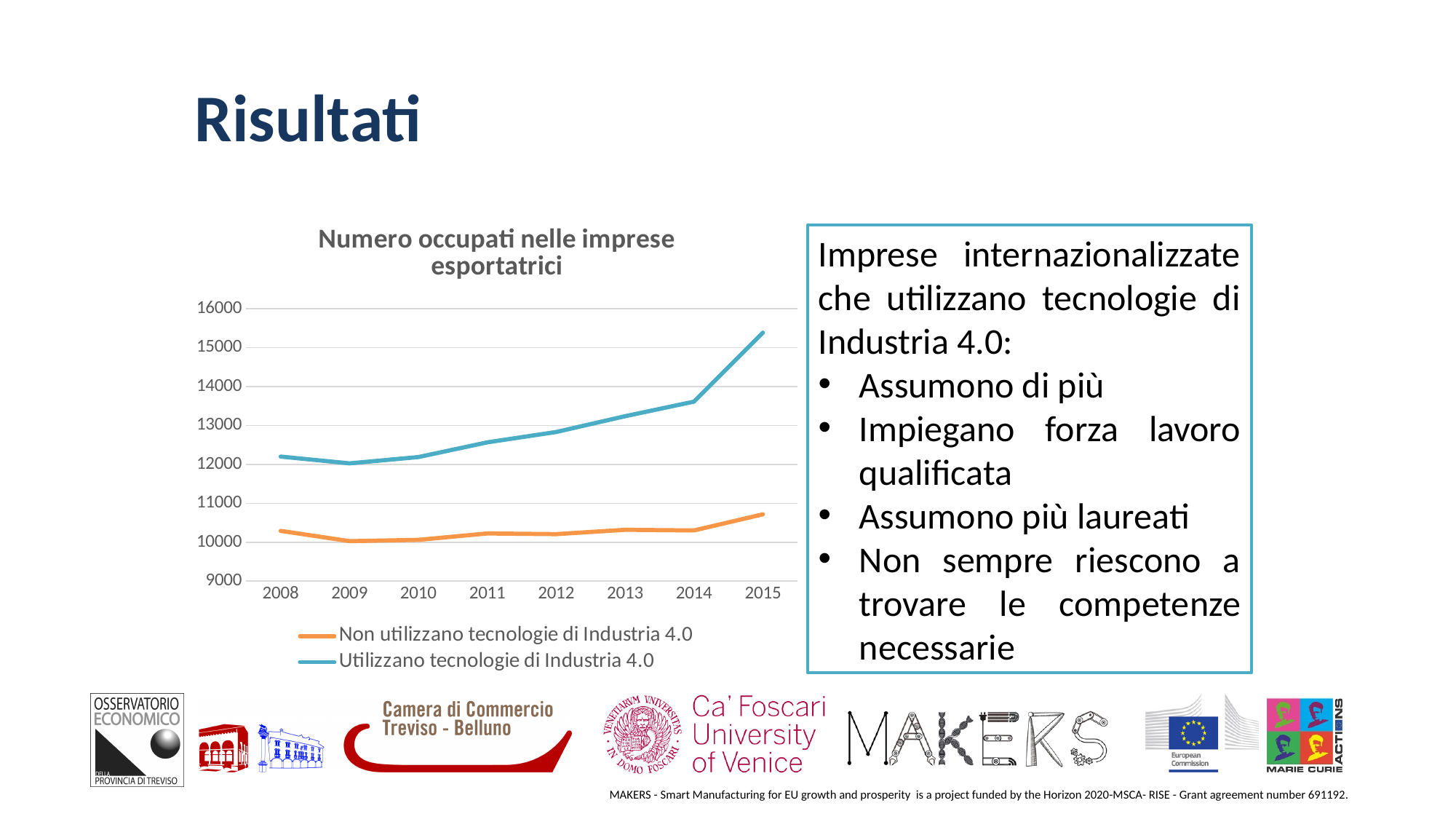
In which year is the 'Non utilizzano tecnologie di Industria 4.0' series highest? 2015 Does the 'Utilizzano tecnologie di Industria 4.0' series rise or fall between 2010 and 2015? rise Is the 2015 value for 'Utilizzano tecnologie di Industria 4.0' greater or less than 15000? greater In which year is the 'Utilizzano tecnologie di Industria 4.0' series highest? 2015 What kind of chart is shown on the slide? line chart Is the 2014 value for 'Utilizzano tecnologie di Industria 4.0' greater or less than 14000? less What is the title of the chart? Numero occupati nelle imprese esportatrici Is the 2015 value for 'Non utilizzano tecnologie di Industria 4.0' greater or less than 11000? less In 2015, which series has the larger value: 'Utilizzano tecnologie di Industria 4.0' or 'Non utilizzano tecnologie di Industria 4.0'? Utilizzano tecnologie di Industria 4.0 How many years are plotted along the x axis? 8 How many series does the legend list? 2 Which series is drawn in orange? Non utilizzano tecnologie di Industria 4.0